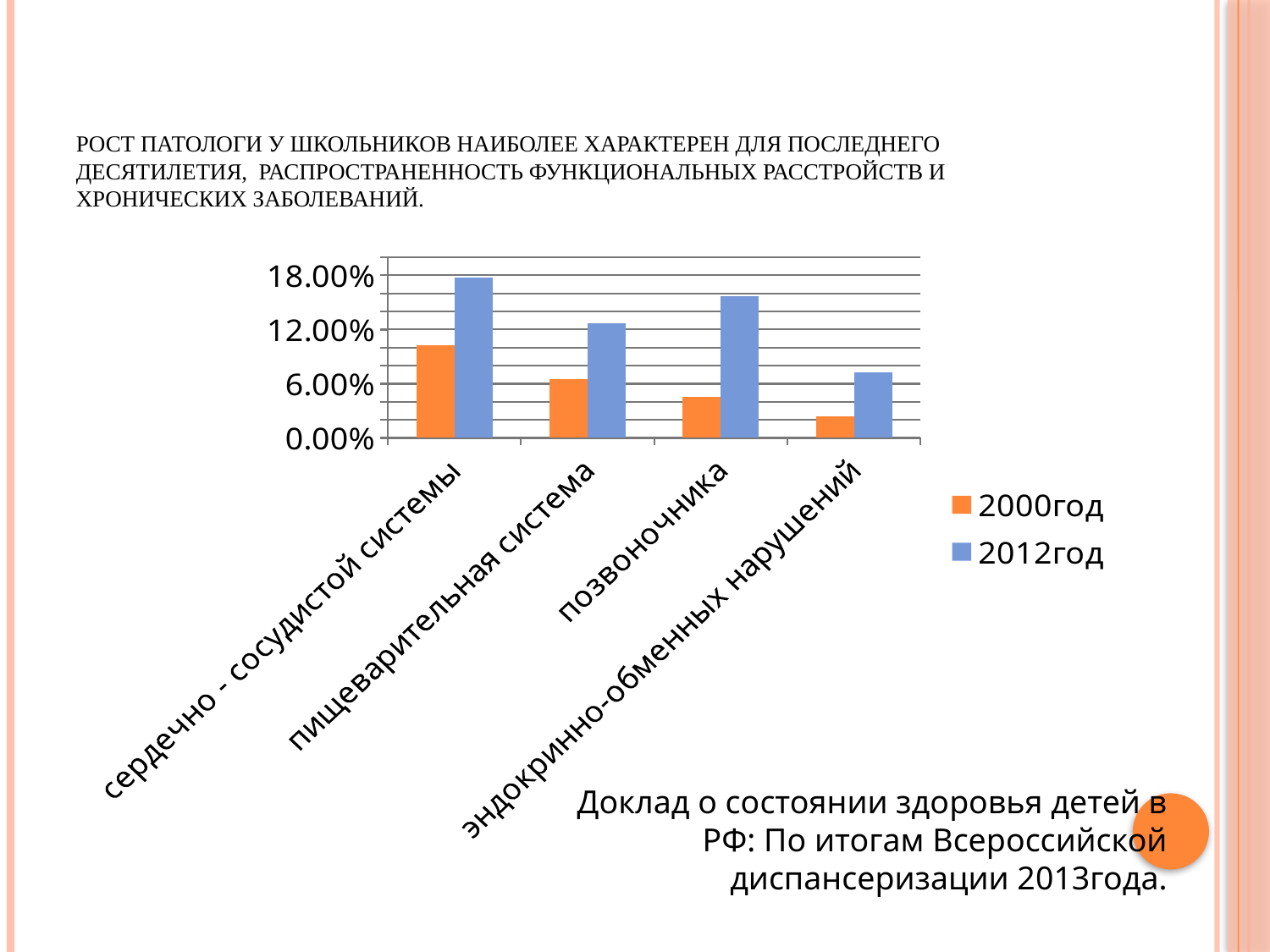
Which category has the lowest value for the 2012год series? эндокринно-обменных нарушений Which colour represents the 2000год series in the chart? orange Which category has the highest value for the 2012год series? сердечно - сосудистой системы How many categories are shown on the x axis of the chart? 4 For пищеварительная система, which series has the larger value, 2000год or 2012год? 2012год Is the 2012год value for сердечно - сосудистой системы greater or less than 12.00%? greater What kind of chart is shown on the slide? bar chart Which category has the highest value for the 2000год series? сердечно - сосудистой системы Is the 2012год value for позвоночника greater or less than 12.00%? greater Is the 2000год value for позвоночника greater or less than 6.00%? less Which category has the lowest value for the 2000год series? эндокринно-обменных нарушений How many series does the chart's legend list? 2